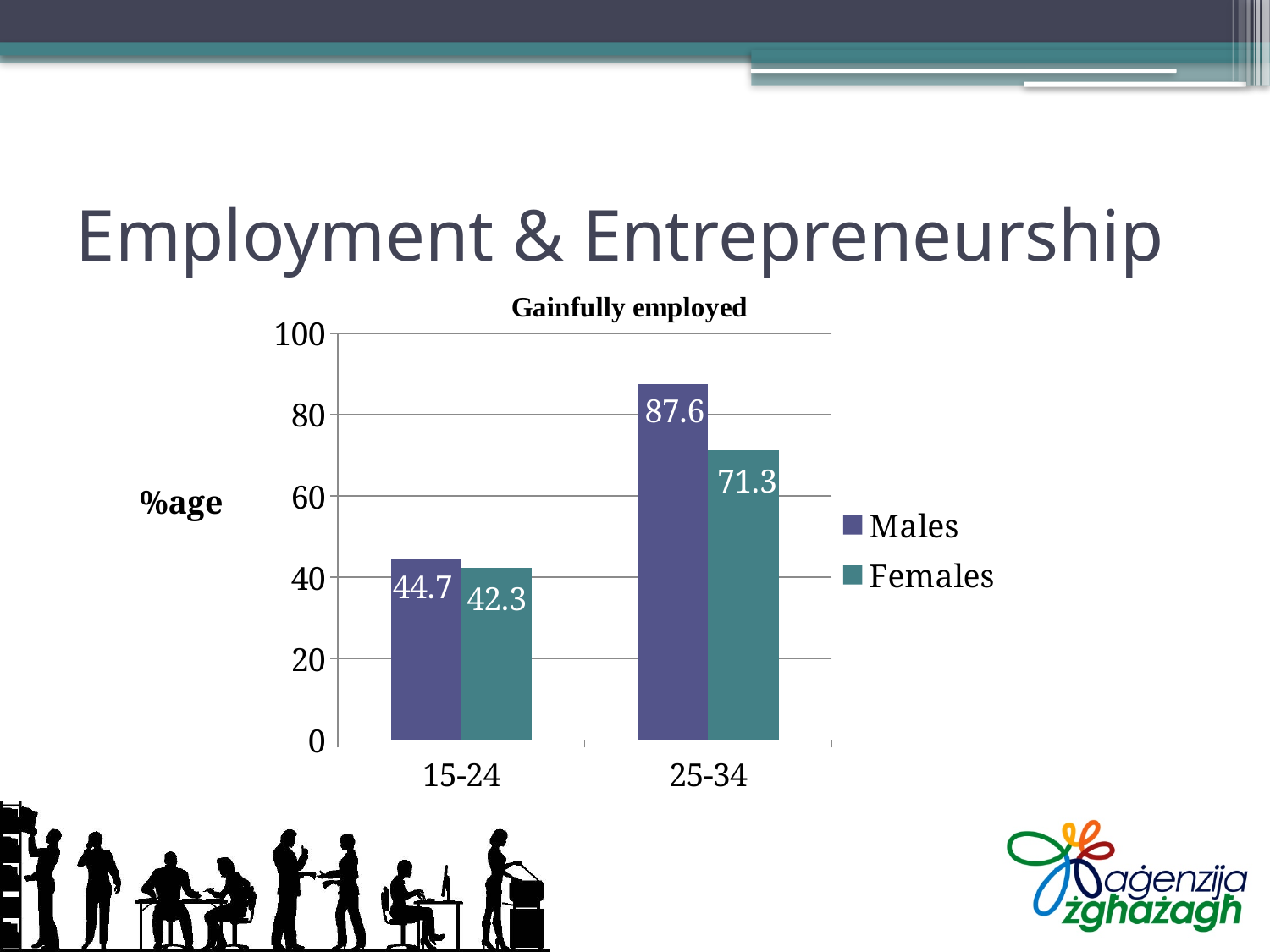
What is the value for Males in the 15-24 age group? 44.7 What is the difference between Males in the 25-34 group and Males in the 15-24 group? 42.9 What is the value for Females in the 15-24 age group? 42.3 What is the value for Females in the 25-34 age group? 71.3 Which age group has the lowest value for Females? 15-24 What is the title of the chart? Gainfully employed Which is larger: Males in 15-24 or Females in 25-34? Females in 25-34 What is the difference between Males and Females in the 25-34 age group? 16.3 Is the value for Males in the 25-34 age group greater or less than 80? greater How many series does the legend list? 2 How many age groups are shown on the x axis? 2 Which age group has the highest value for Males? 25-34